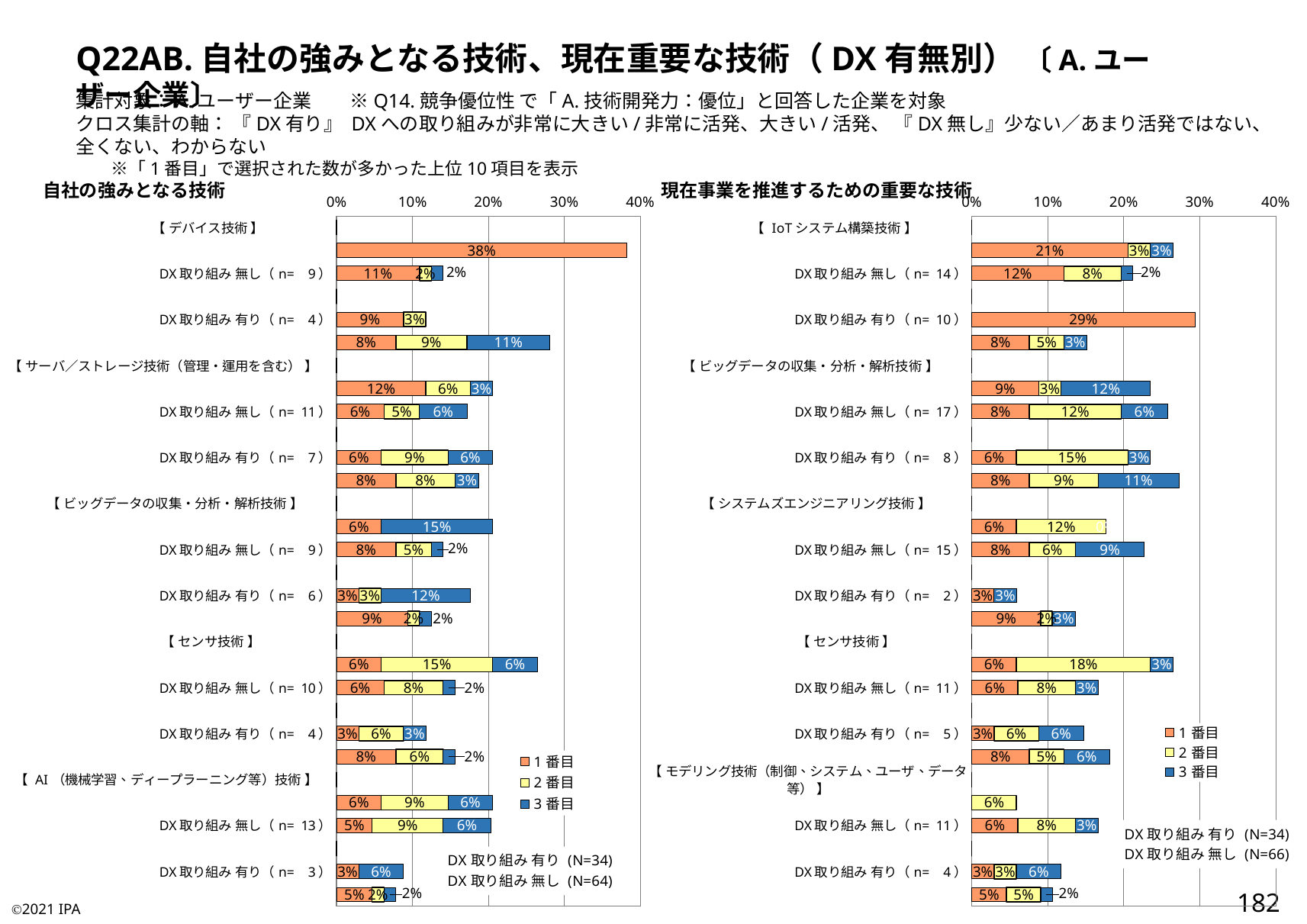
In the right chart (現在事業を推進するための重要な技術), what is the largest single data label shown? 29% In the left chart, what is the total of the bar directly below the 【ビッグデータの収集・分析・解析技術】 header, with segments 6% and 15%? 21% How many series does the legend list for the left chart (自社の強みとなる技術)? 3 What is the difference between the 38% bar in the left chart and the 29% bar in the right chart? 9% What is the maximum value shown on the horizontal axis of both charts? 40% What are the three legend entries shown for the charts? 1番目, 2番目, 3番目 In the right chart, what is the total of the topmost bar (directly below the 【IoTシステム構築技術】 header), with segments 21%, 3% and 3%? 27% Which is larger: the 1番目 value of the topmost bar in the left chart (38%) or the 1番目 value of the topmost bar in the right chart (21%)? The left chart (38%) What kind of chart is used on this slide for 自社の強みとなる技術 and 現在事業を推進するための重要な技術? Stacked horizontal bar chart In the left chart (自社の強みとなる技術), what is the largest single data label shown? 38% In the right chart, what is the total of the bar directly below the 【センサ技術】 header, with segments 6%, 18% and 3%? 27% According to the annotation on the right chart, what is the N for DX取り組み無し? N=66